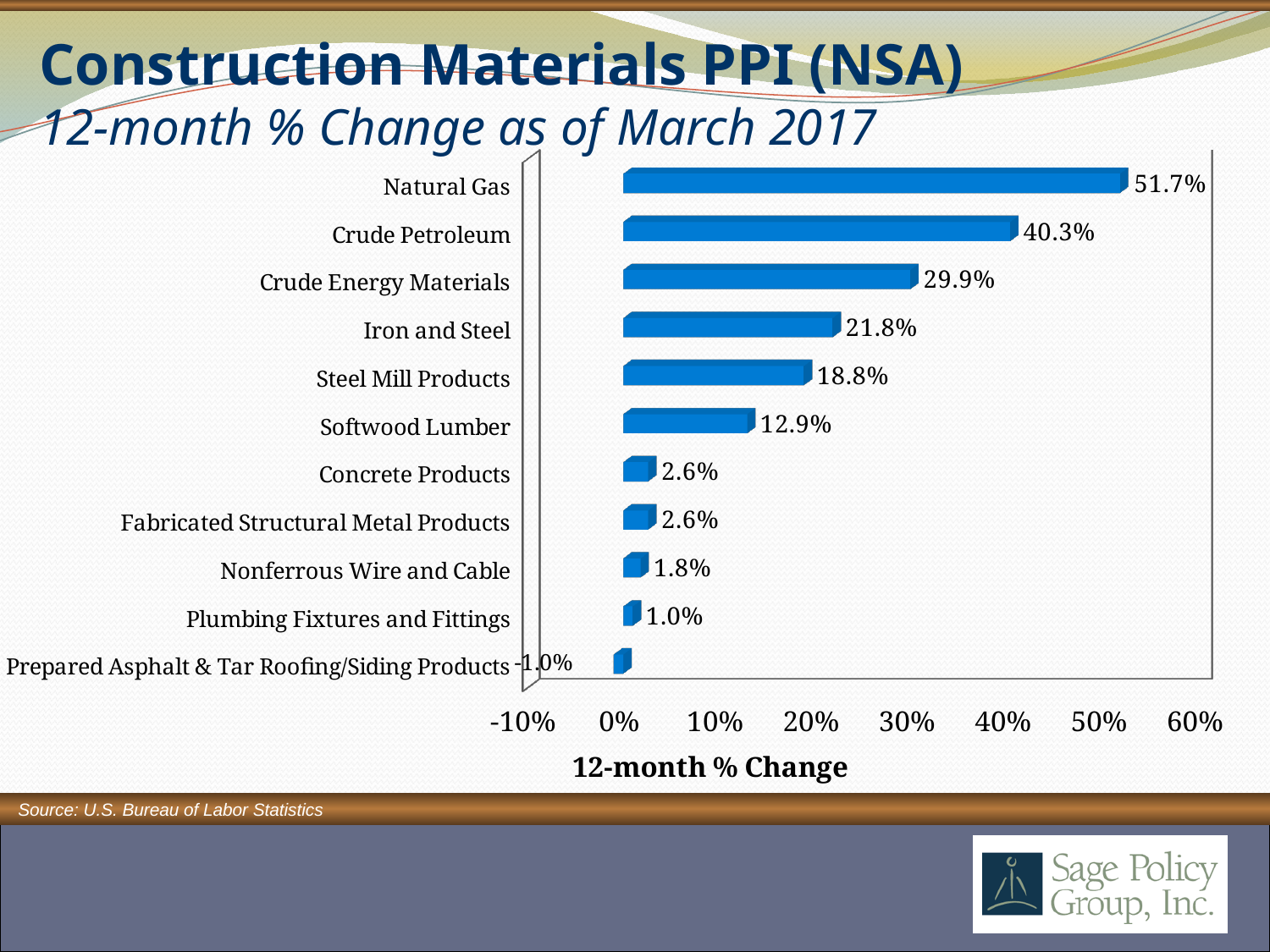
How many categories are shown in the chart? 11 What is the 12-month % change for Softwood Lumber? 12.9% What is the difference between the 12-month % change for Crude Petroleum and Crude Energy Materials? 10.4% What is the x-axis label of the chart? 12-month % Change What kind of chart is shown on the slide? Bar chart What is the source cited for the chart? U.S. Bureau of Labor Statistics What is the 12-month % change for Prepared Asphalt & Tar Roofing/Siding Products? -1.0% Is the value for Crude Petroleum greater or less than 30%? greater Which category has the highest 12-month % change? Natural Gas Which has a larger 12-month % change, Iron and Steel or Steel Mill Products? Iron and Steel Which category has the lowest 12-month % change? Prepared Asphalt & Tar Roofing/Siding Products What is the 12-month % change for Natural Gas? 51.7%